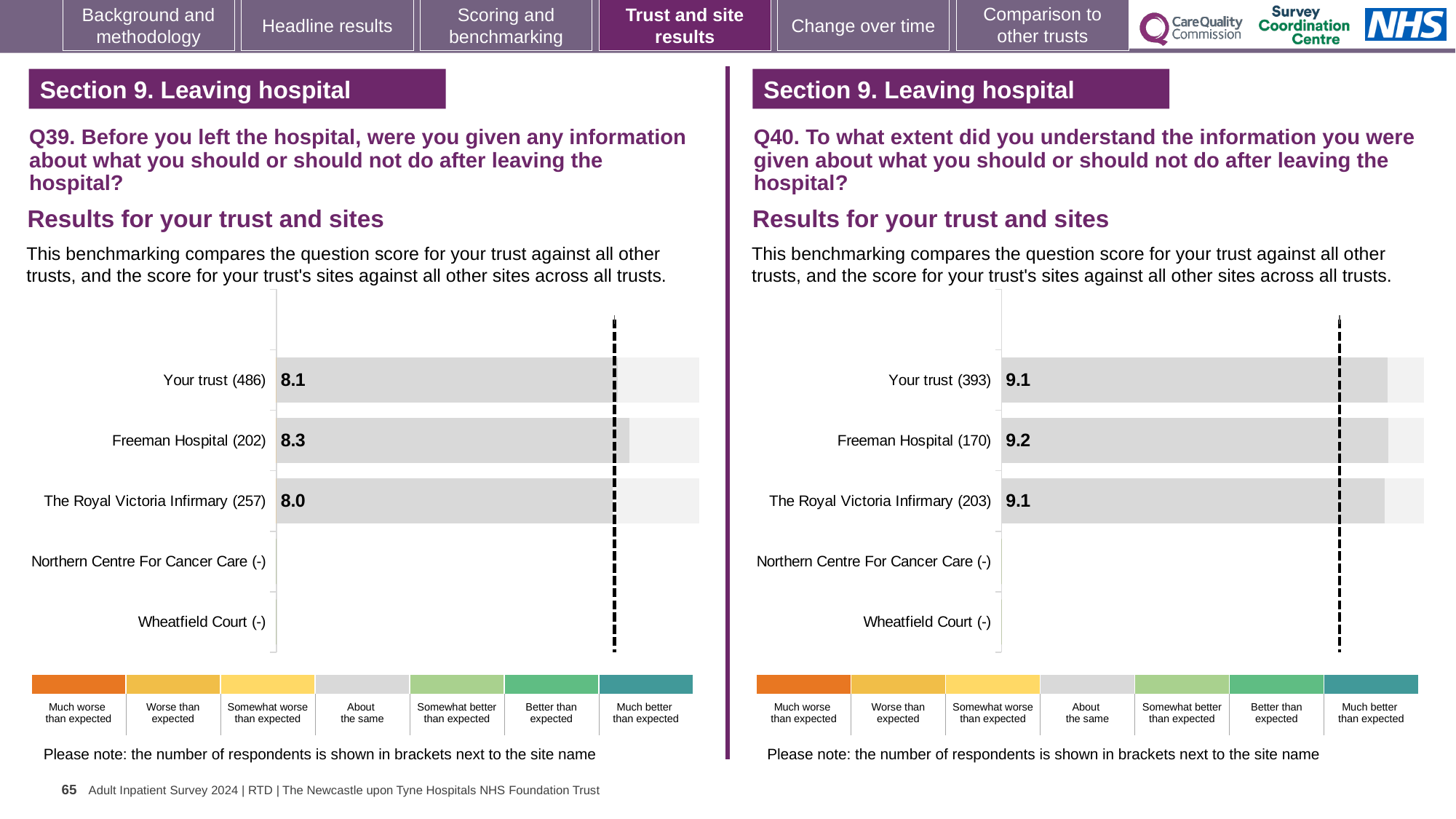
On the Q40 chart (right), how many rows (trust and sites) are listed on the vertical axis? 5 What kind of chart is used on the Q39 chart (left)? Bar chart On the Q39 chart (left), which site has the highest score? Freeman Hospital On the Q39 chart (left), what is the score for Your trust? 8.1 On the Q40 chart (right), what is the score for Freeman Hospital? 9.2 On the Q39 chart (left), what is the difference between the Freeman Hospital score and The Royal Victoria Infirmary score? 0.3 On the Q40 chart (right), what is the score for The Royal Victoria Infirmary? 9.1 On the Q39 chart (left), how many respondents are shown for Your trust? 486 On the Q39 chart (left), what is the score for Freeman Hospital? 8.3 On the Q39 chart (left), what is the score for The Royal Victoria Infirmary? 8.0 On the Q40 chart (right), how many respondents are shown for Your trust? 393 On the Q40 chart (right), what is the difference between the Freeman Hospital score and the Your trust score? 0.1